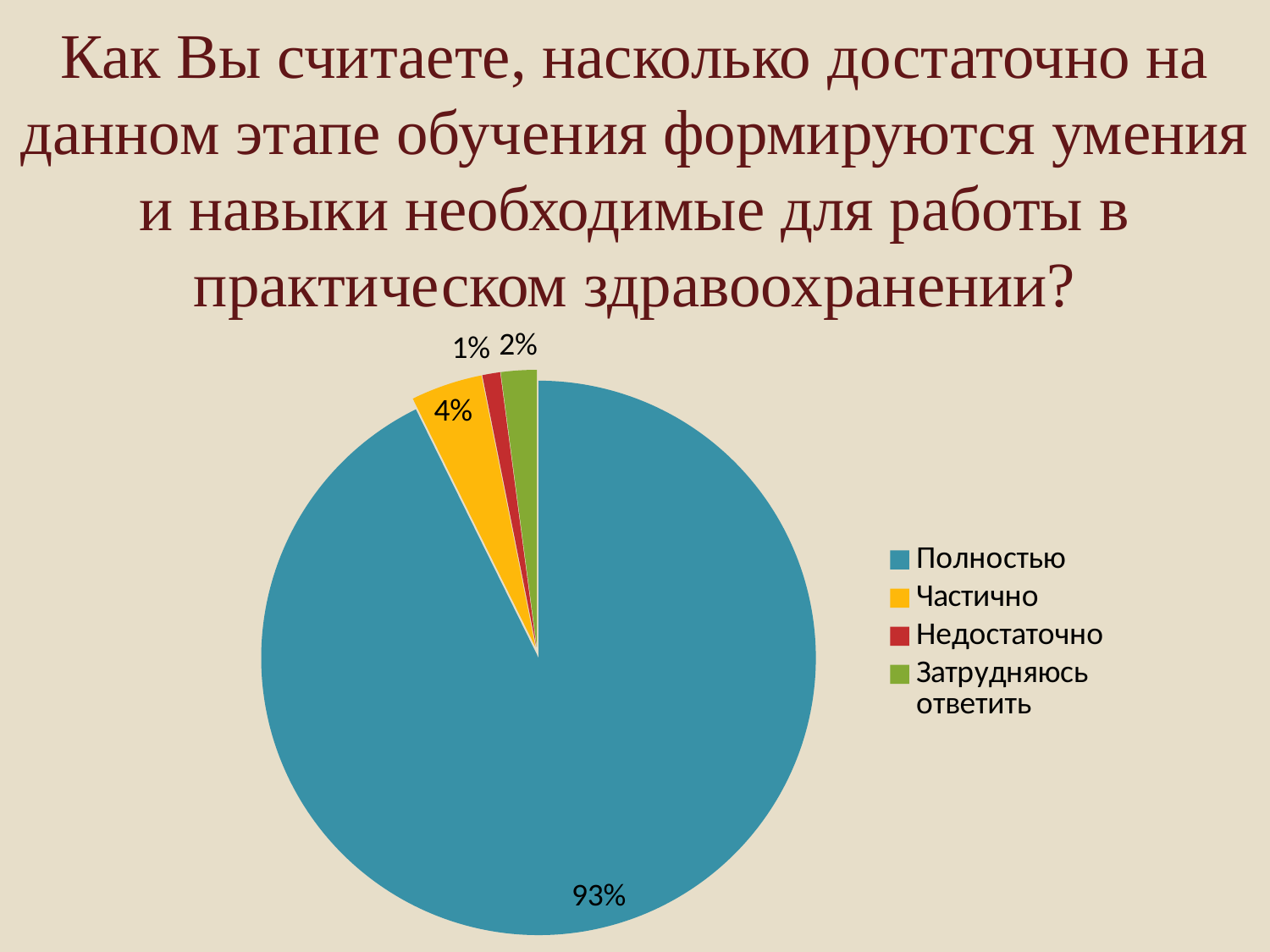
What colour is the slice for "Полностью"? blue How many categories does the legend list? 4 Which category has the smallest slice of the pie? Недостаточно What share of the pie is labelled "Затрудняюсь ответить"? 2% What share of the pie is labelled "Недостаточно"? 1% Which category has the largest slice of the pie? Полностью What kind of chart is shown on the slide? pie chart What share of the pie is labelled "Частично"? 4% Which is larger, the share for "Частично" or the share for "Затрудняюсь ответить"? Частично What is the difference between the shares for "Полностью" and "Частично"? 89% What colour is the slice for "Частично"? yellow